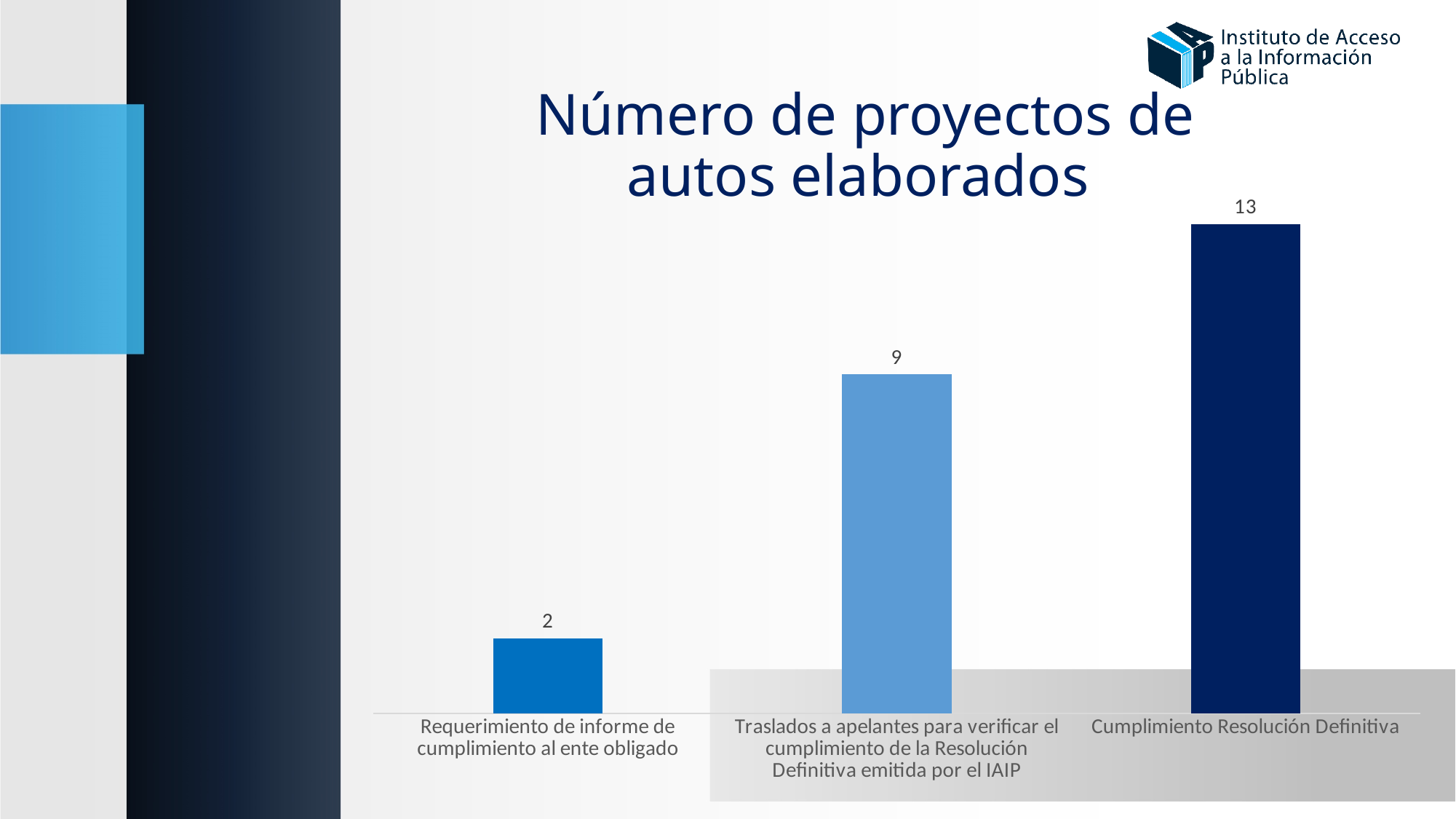
Which is larger: the value for "Traslados a apelantes para verificar el cumplimiento de la Resolución Definitiva emitida por el IAIP" or for "Requerimiento de informe de cumplimiento al ente obligado"? Traslados a apelantes para verificar el cumplimiento de la Resolución Definitiva emitida por el IAIP What is the value for "Requerimiento de informe de cumplimiento al ente obligado"? 2 Which category has the highest value? Cumplimiento Resolución Definitiva Which category has the lowest value? Requerimiento de informe de cumplimiento al ente obligado How many categories are shown in the chart? 3 What is the value for "Traslados a apelantes para verificar el cumplimiento de la Resolución Definitiva emitida por el IAIP"? 9 What is the difference between the values for "Cumplimiento Resolución Definitiva" and "Requerimiento de informe de cumplimiento al ente obligado"? 11 What is the title of the chart? Número de proyectos de autos elaborados What is the difference between the values for "Cumplimiento Resolución Definitiva" and "Traslados a apelantes para verificar el cumplimiento de la Resolución Definitiva emitida por el IAIP"? 4 What is the value for "Cumplimiento Resolución Definitiva"? 13 Do the values rise or fall from left to right across the categories? Rise What kind of chart is shown on the slide? Bar chart